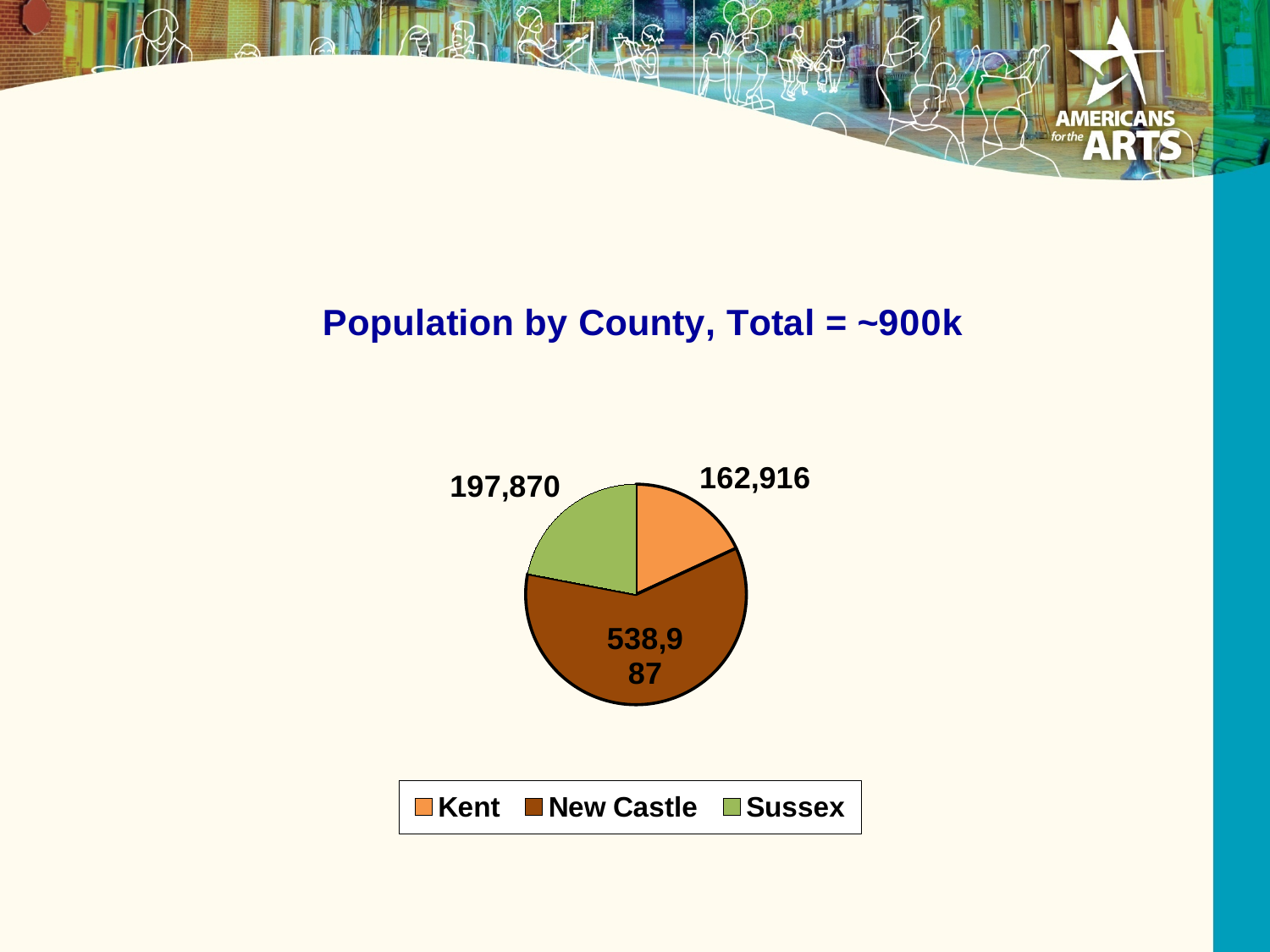
What is the population of Sussex county? 197,870 What is the title of the chart? Population by County, Total = ~900k What is the population of New Castle county? 538,987 What is the difference in population between Sussex and Kent? 34,954 Which colour represents Sussex in the pie chart? green What type of chart is shown on the slide? pie chart What is the population of Kent county? 162,916 Which county has the smallest population? Kent Which county has the largest population? New Castle How many counties are shown in the pie chart? 3 Which county has a larger population, Sussex or Kent? Sussex What is the difference in population between New Castle and Sussex? 341,117